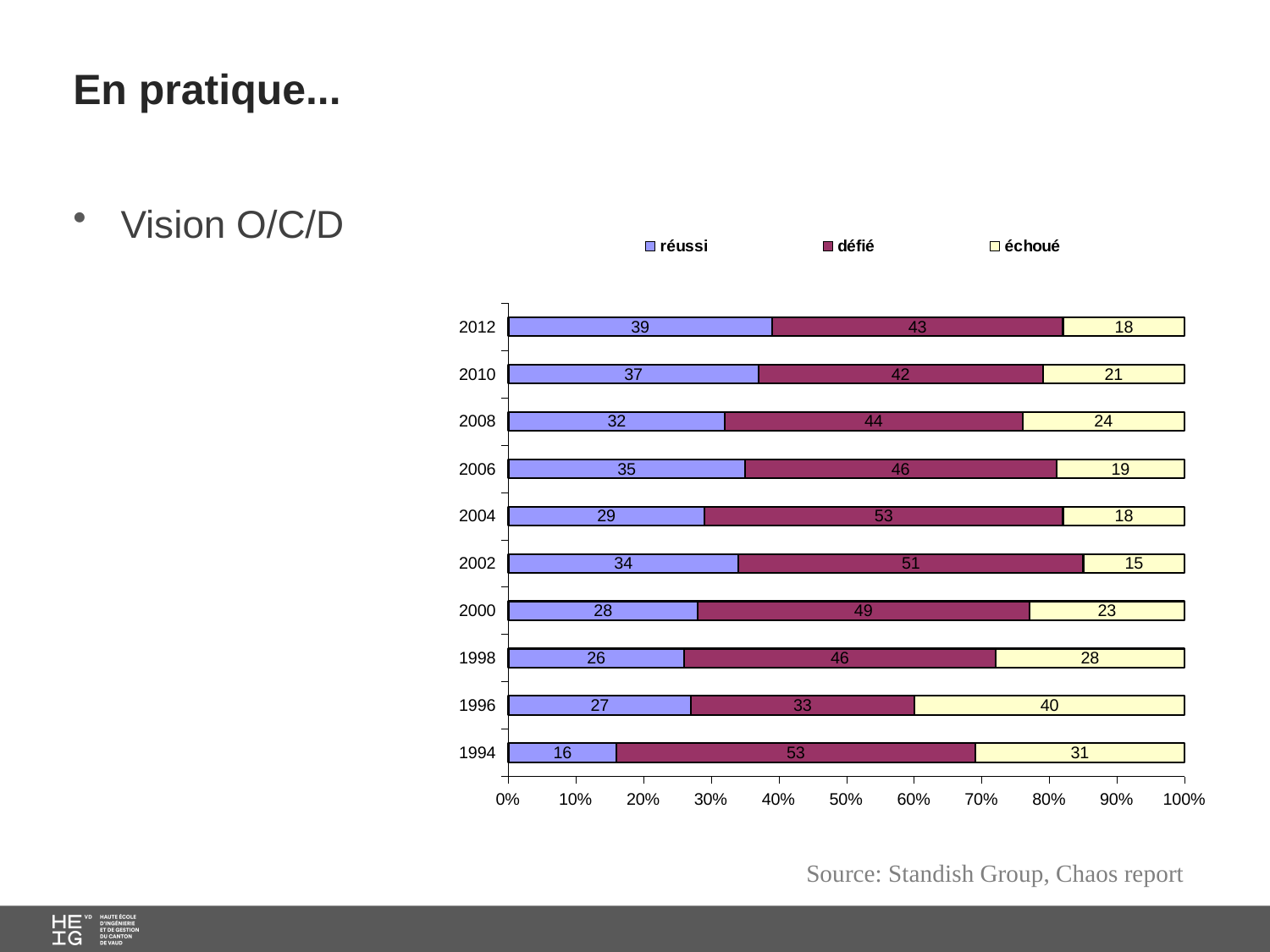
What are the three series listed in the legend? réussi, défié, échoué What is the value of the défié series for 2004? 53 How many series does the legend list? 3 How many years are shown on the chart? 10 What is the difference between the réussi values for 2012 and 1994? 23 What kind of chart is shown on the slide? Stacked bar chart Which is larger, the défié value for 2002 or the défié value for 1996? 2002 What is the total of the stacked bar for 2008? 100 What is the value of the réussi series for 2012? 39 Which year has the highest échoué value? 1996 Which year has the lowest réussi value? 1994 What is the value of the échoué series for 1996? 40